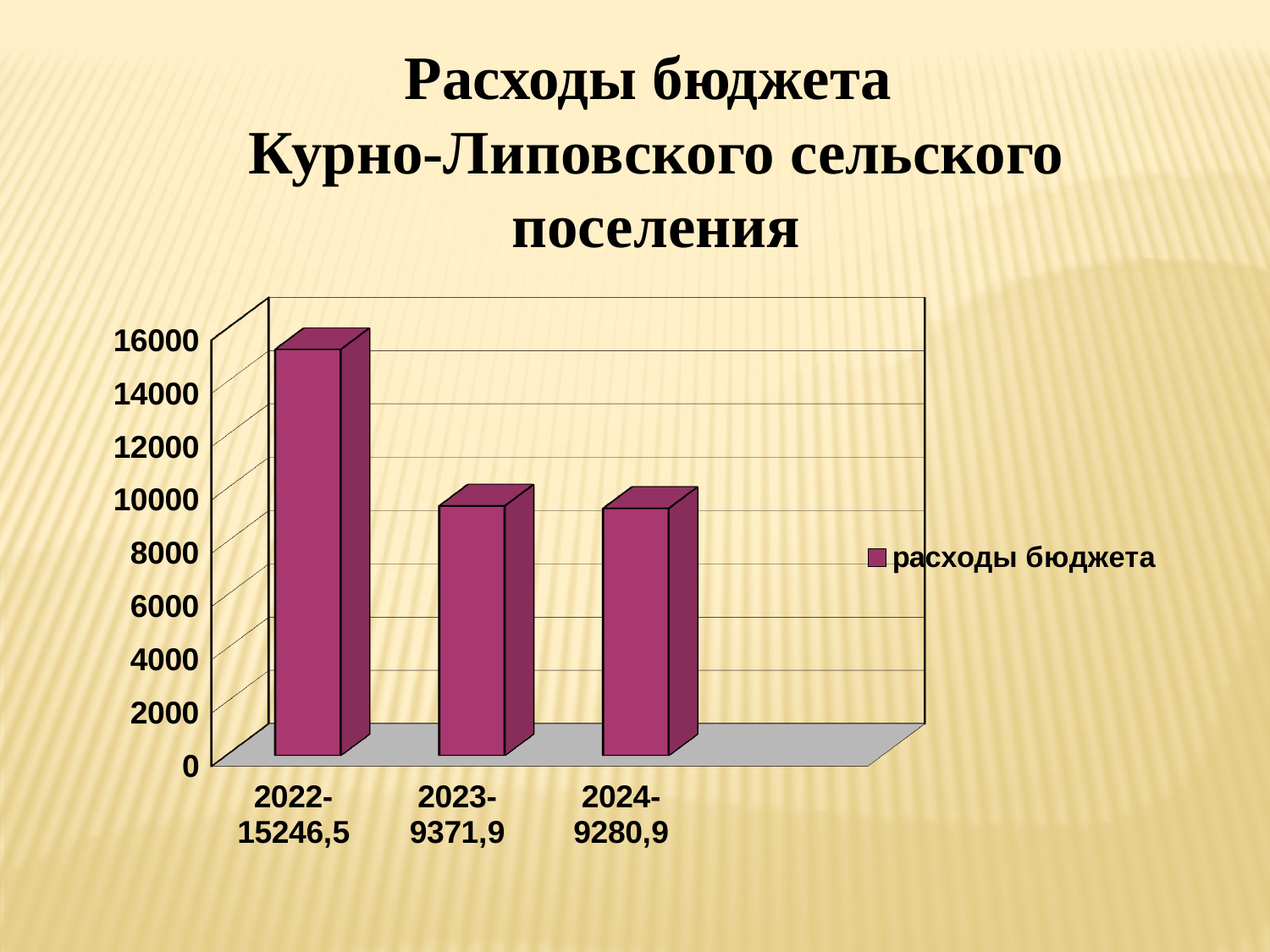
What is the budget expenditure value shown for 2022? 15246,5 What is the difference between the budget expenditure for 2023 and 2024? 91 What is the budget expenditure value shown for 2023? 9371,9 Do the values rise or fall from 2022 to 2024? fall What is the difference between the budget expenditure for 2022 and 2023? 5874,6 Which year has the lowest budget expenditure according to the printed values? 2024 How many years (bars) are shown on the chart? 3 Which is larger, the budget expenditure for 2022 or for 2024? 2022 Which year has the highest budget expenditure? 2022 How many series does the legend list? 1 Is the value for 2022 greater or less than 14000? greater What is the budget expenditure value shown for 2024? 9280,9